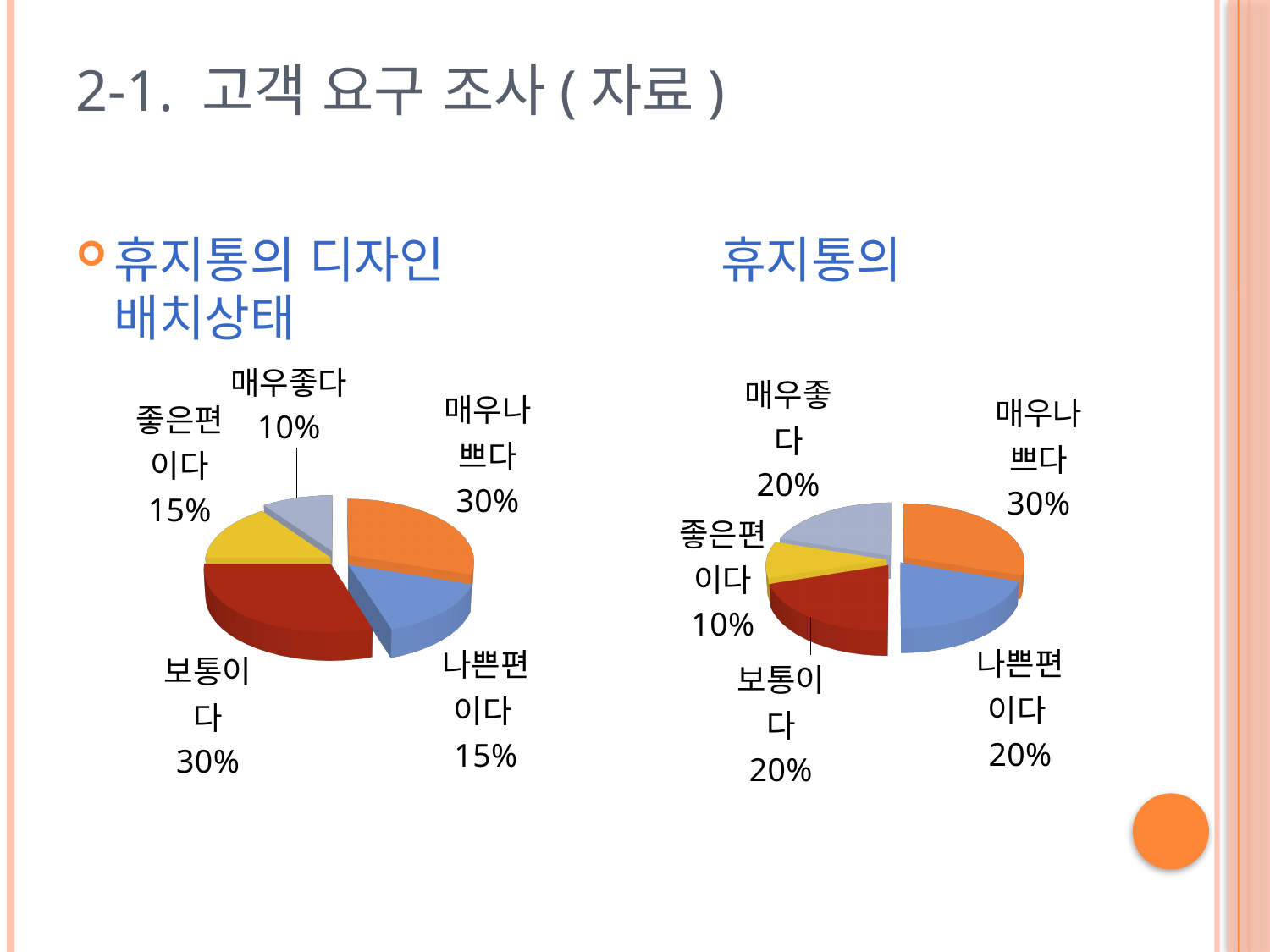
In the right pie chart, which category has the smallest share? 좋은편이다 In the left pie chart, what is the difference between the shares of 매우나쁘다 and 나쁜편이다? 15% In the left pie chart, what percentage is labelled for 보통이다? 30% In the left pie chart, which category has the smallest share? 매우좋다 In the right pie chart, which category has the largest share? 매우나쁘다 What type of chart is shown on the right side of the slide? Pie chart In the right pie chart, what percentage is labelled for 매우좋다? 20% In the right pie chart, which is larger, the share of 매우나쁘다 or the share of 나쁜편이다? 매우나쁘다 How many slices does the left pie chart have? 5 In the left pie chart, what colour is the 보통이다 slice? Red In the right pie chart, what percentage is labelled for 좋은편이다? 10% In the left pie chart, what percentage is labelled for 매우좋다? 10%